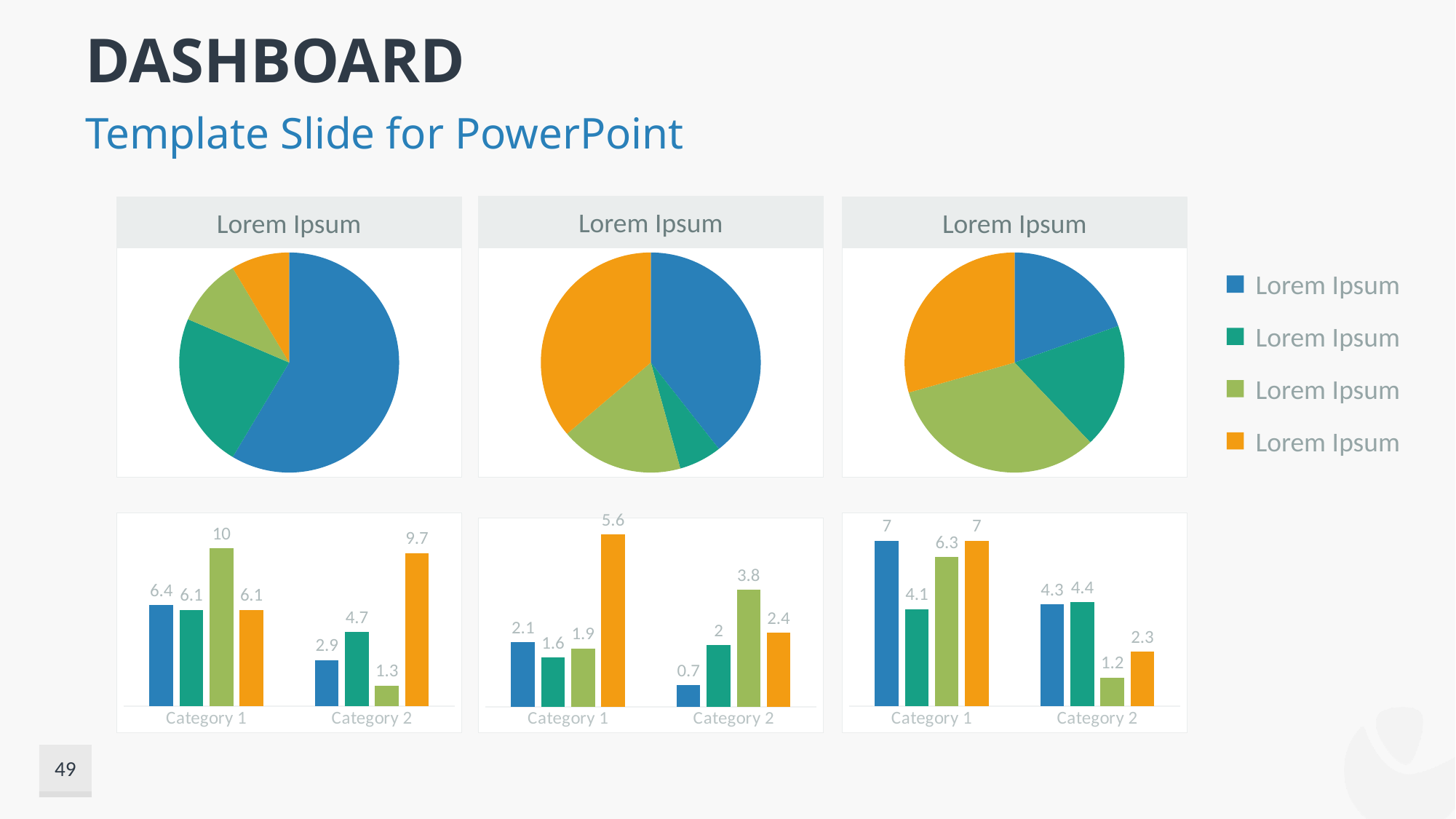
In the left bar chart, what is the highest value shown for Category 2? 9.7 In the middle bar chart, does the orange series rise or fall from Category 1 to Category 2? Fall How many series does the legend on the right of the slide list? 4 In the middle bar chart, what is the lowest value shown for Category 2? 0.7 In the middle bar chart, which is larger: the orange bar for Category 1 or the green bar for Category 2? The orange bar for Category 1 (5.6) In the left bar chart, how much larger is the orange bar for Category 2 than the orange bar for Category 1? 3.6 What kind of chart are the three charts in the top row? Pie chart In the left pie chart, which colour slice is the largest? Blue How many categories are shown on the x axis of the left bar chart? 2 In the right bar chart, what is the difference between the blue bar for Category 1 and the blue bar for Category 2? 2.7